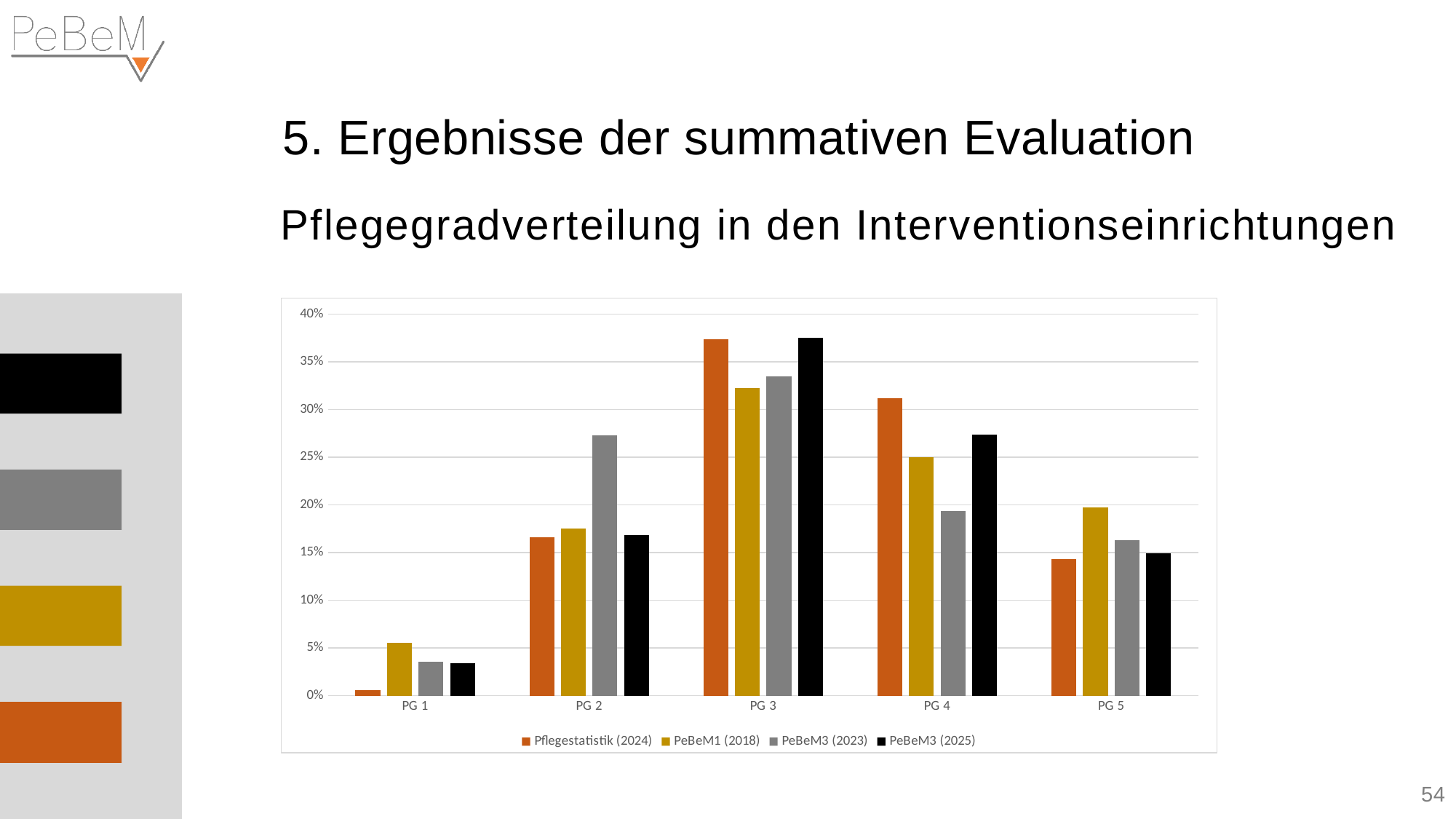
Is the value for Pflegestatistik (2024) at PG 4 greater or less than 25%? greater How many categories (Pflegegrade) are shown on the x axis? 5 Is the value for PeBeM3 (2023) at PG 2 greater or less than 25%? greater Is the value for PeBeM1 (2018) at PG 4 greater or less than 30%? less What kind of chart is shown on the slide? bar chart At PG 2, which is larger: PeBeM3 (2023) or PeBeM1 (2018)? PeBeM3 (2023) What colour represents the PeBeM3 (2025) series in the legend? black Which category has the lowest value for Pflegestatistik (2024)? PG 1 At PG 5, which is larger: PeBeM1 (2018) or Pflegestatistik (2024)? PeBeM1 (2018) How many series does the legend list? 4 Which category has the highest value for PeBeM1 (2018)? PG 3 Which category has the highest value for Pflegestatistik (2024)? PG 3